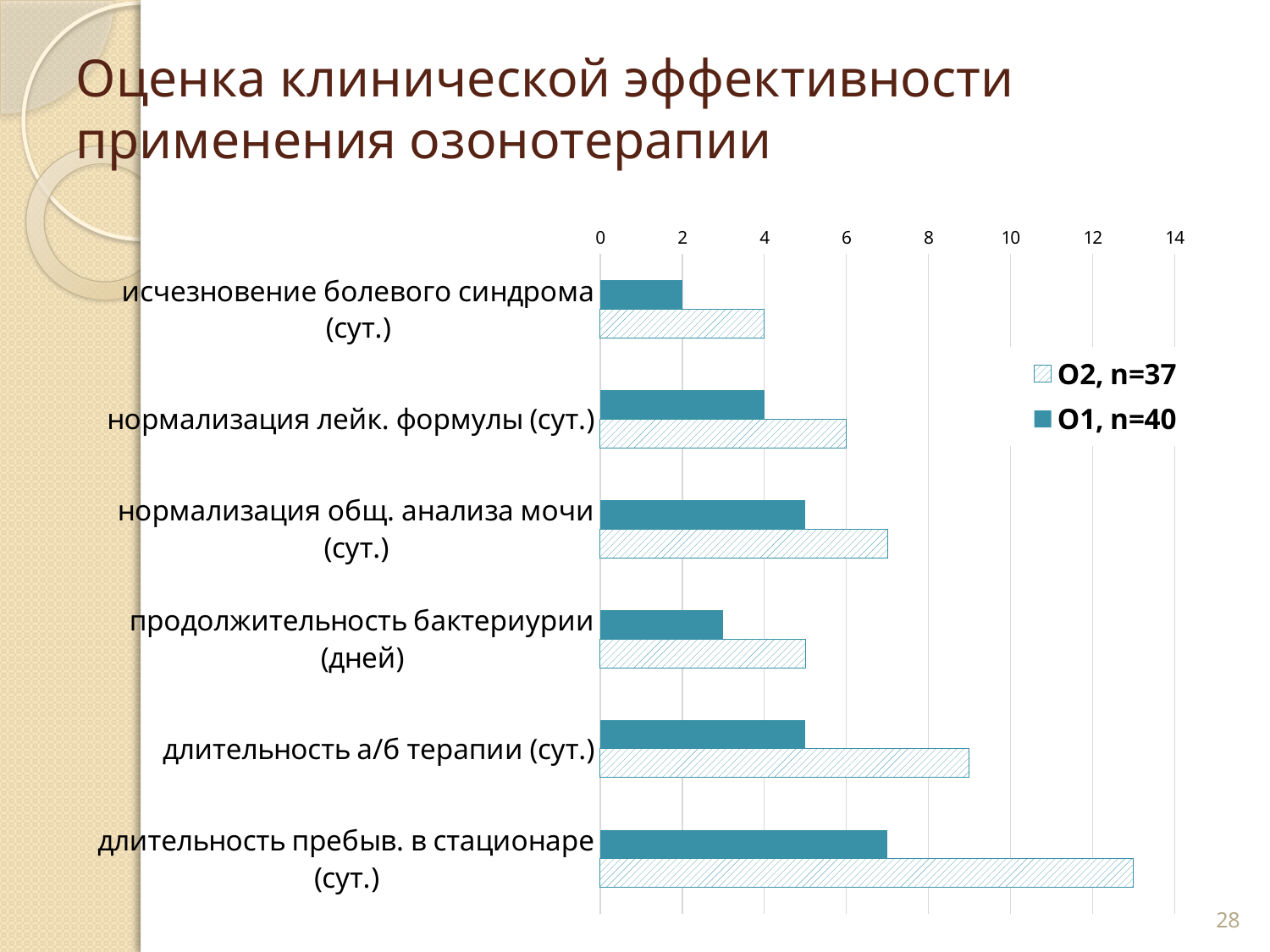
What is the value of О1, n=40 for исчезновение болевого синдрома (сут.)? 2 What is the value of О2, n=37 for исчезновение болевого синдрома (сут.)? 4 What is the value of О1, n=40 for нормализация лейк. формулы (сут.)? 4 What is the value of О2, n=37 for нормализация лейк. формулы (сут.)? 6 Which category has the highest value for О2, n=37? длительность пребыв. в стационаре (сут.) How many categories are shown on the chart? 6 Which series is drawn with a hatched pattern in the legend? О2, n=37 Is the value of О2, n=37 for длительность пребыв. в стационаре (сут.) greater or less than 12? greater How many series does the legend list? 2 Which category has the lowest value for О1, n=40? исчезновение болевого синдрома (сут.) What kind of chart is shown on the slide? bar chart For длительность а/б терапии (сут.), which series has the larger value, О1, n=40 or О2, n=37? О2, n=37